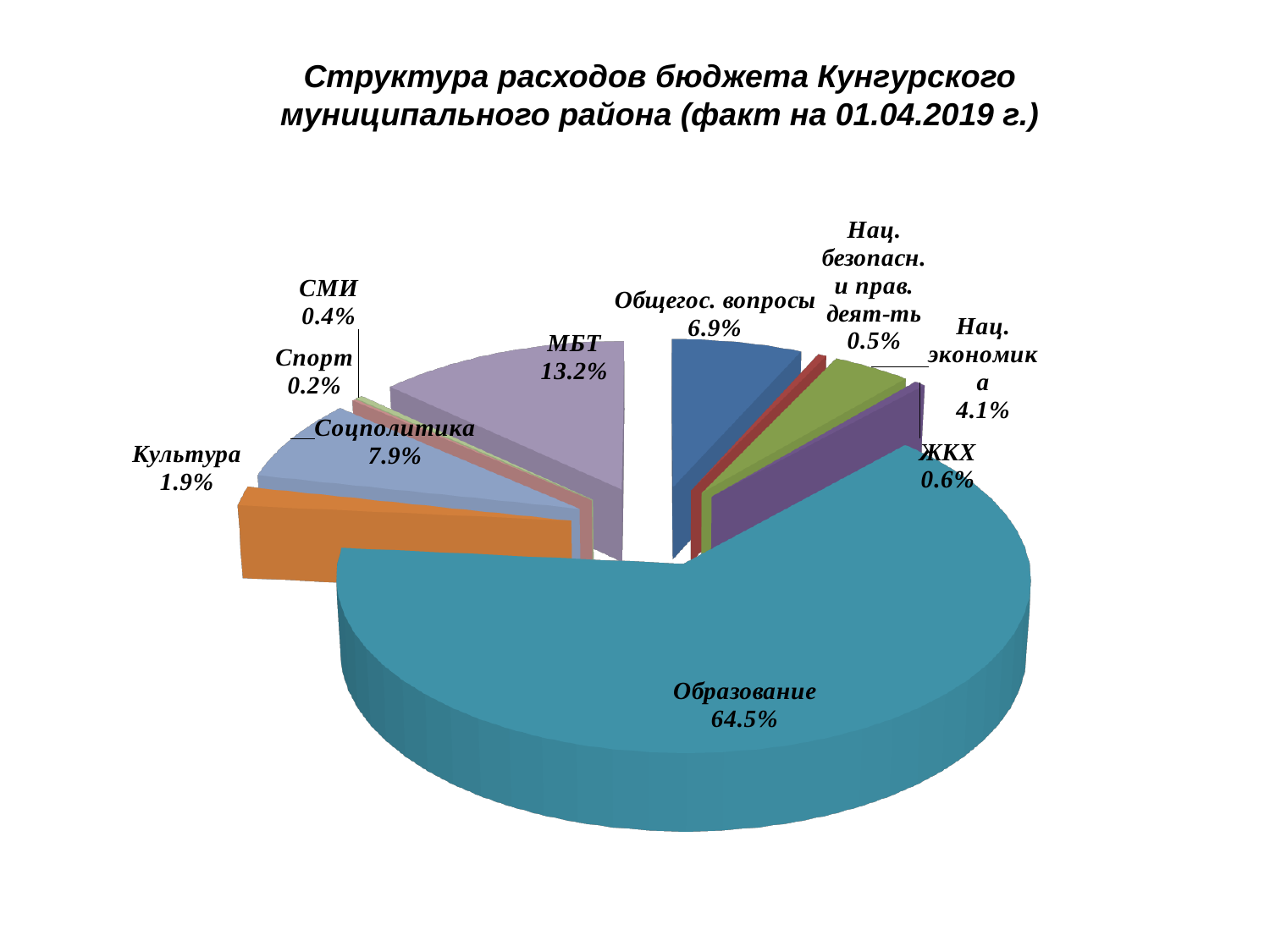
What is the date given in the chart title? 01.04.2019 г. What share is shown for МБТ? 13.2% What share is shown for Нац. экономика? 4.1% What share is shown for Соцполитика? 7.9% Which category has the largest share of the pie? Образование Which category has the smallest share of the pie? Спорт Which is larger, the share for Общегос. вопросы or the share for Соцполитика? Соцполитика How many categories are shown in the pie chart? 10 What is the difference between the shares for МБТ and Общегос. вопросы? 6.3% What share is shown for Спорт? 0.2% What kind of chart is shown on the slide? Pie chart What share of expenditure is labelled for Образование? 64.5%